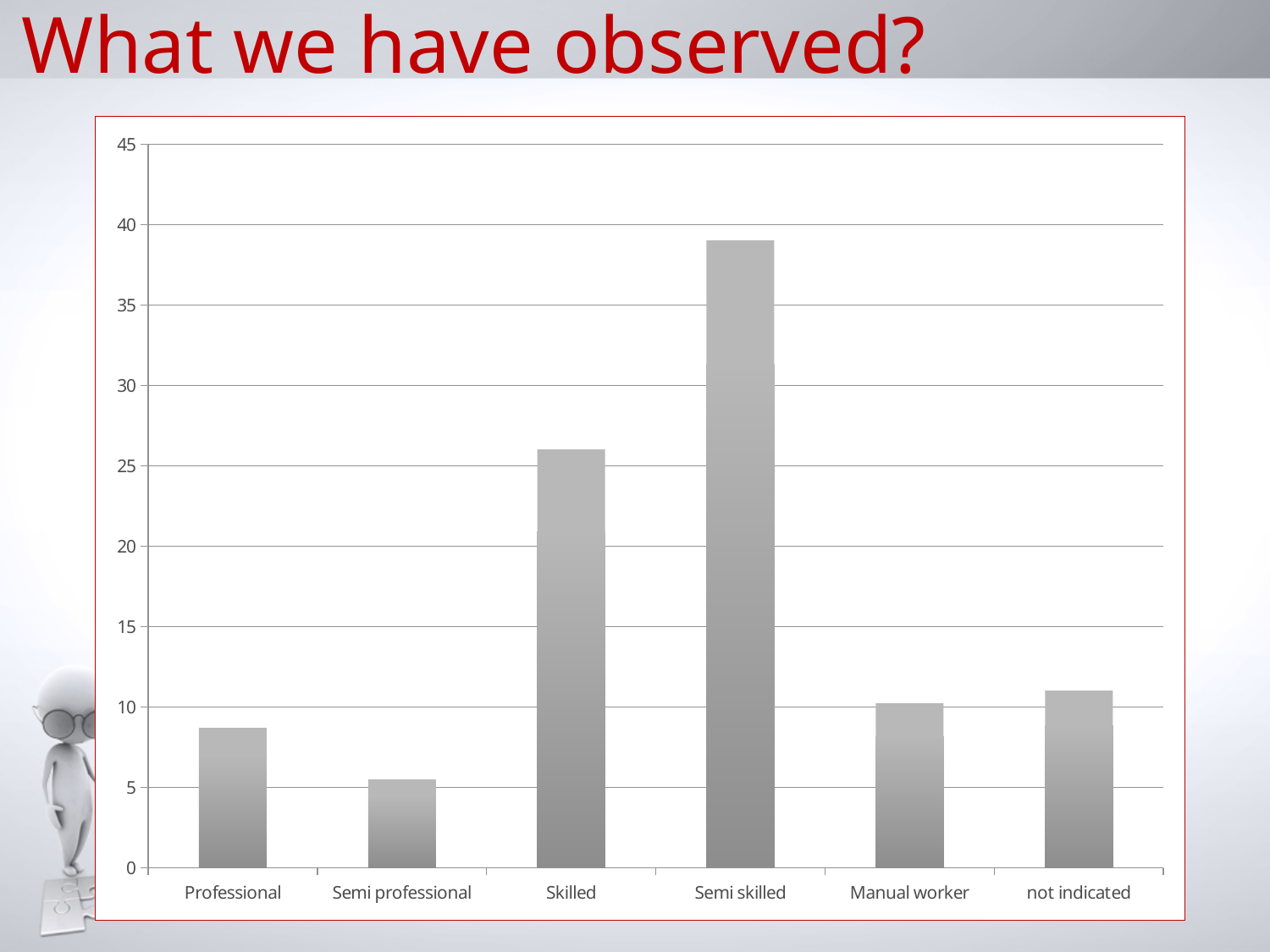
Is the value for Professional greater or less than 10? less Is the value for Semi professional greater or less than 10? less What kind of chart is shown on the slide? bar chart Which is larger, the value for Skilled or the value for Manual worker? Skilled Is the value for not indicated greater or less than 15? less Which is larger, the value for Professional or the value for Semi professional? Professional What is the highest value shown on the y axis of the chart? 45 Which category has the lowest bar in the chart? Semi professional Which category has the highest bar in the chart? Semi skilled How many categories are shown on the x axis of the chart? 6